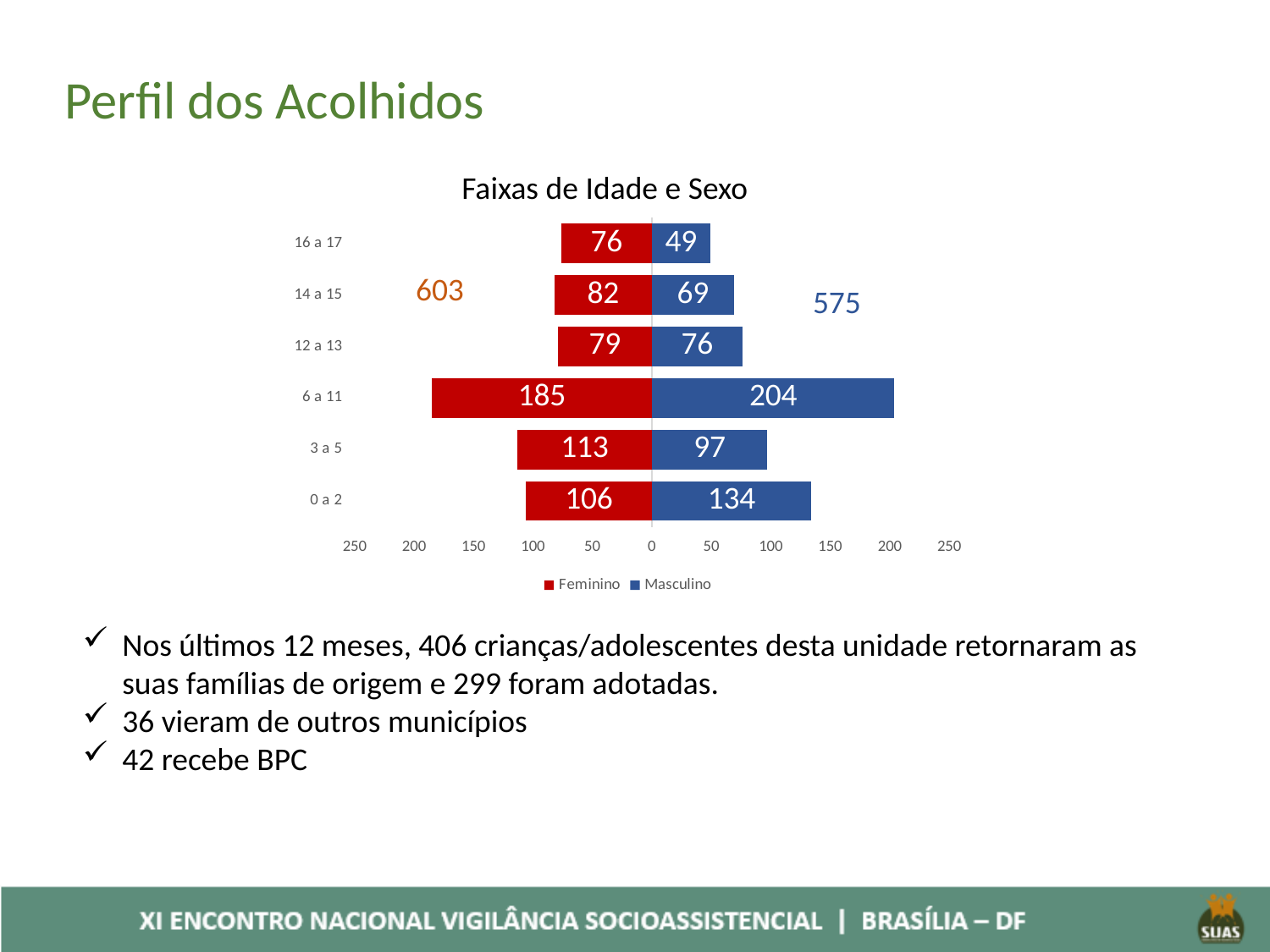
What is the total of the Feminino and Masculino values for the 12 a 13 age group? 155 Which age group has the lowest Feminino value? 16 a 17 What is the Masculino value for the 0 a 2 age group? 134 What is the difference between the Masculino and Feminino values for the 0 a 2 age group? 28 How many age groups are shown on the chart? 6 What is the title of the chart? Faixas de Idade e Sexo Which is larger for the 3 a 5 age group, Feminino or Masculino? Feminino What is the Masculino value for the 16 a 17 age group? 49 Which age group has the highest Masculino value? 6 a 11 What is the Feminino value for the 6 a 11 age group? 185 How many series does the legend list? 2 What kind of chart is shown on the slide? Bar chart